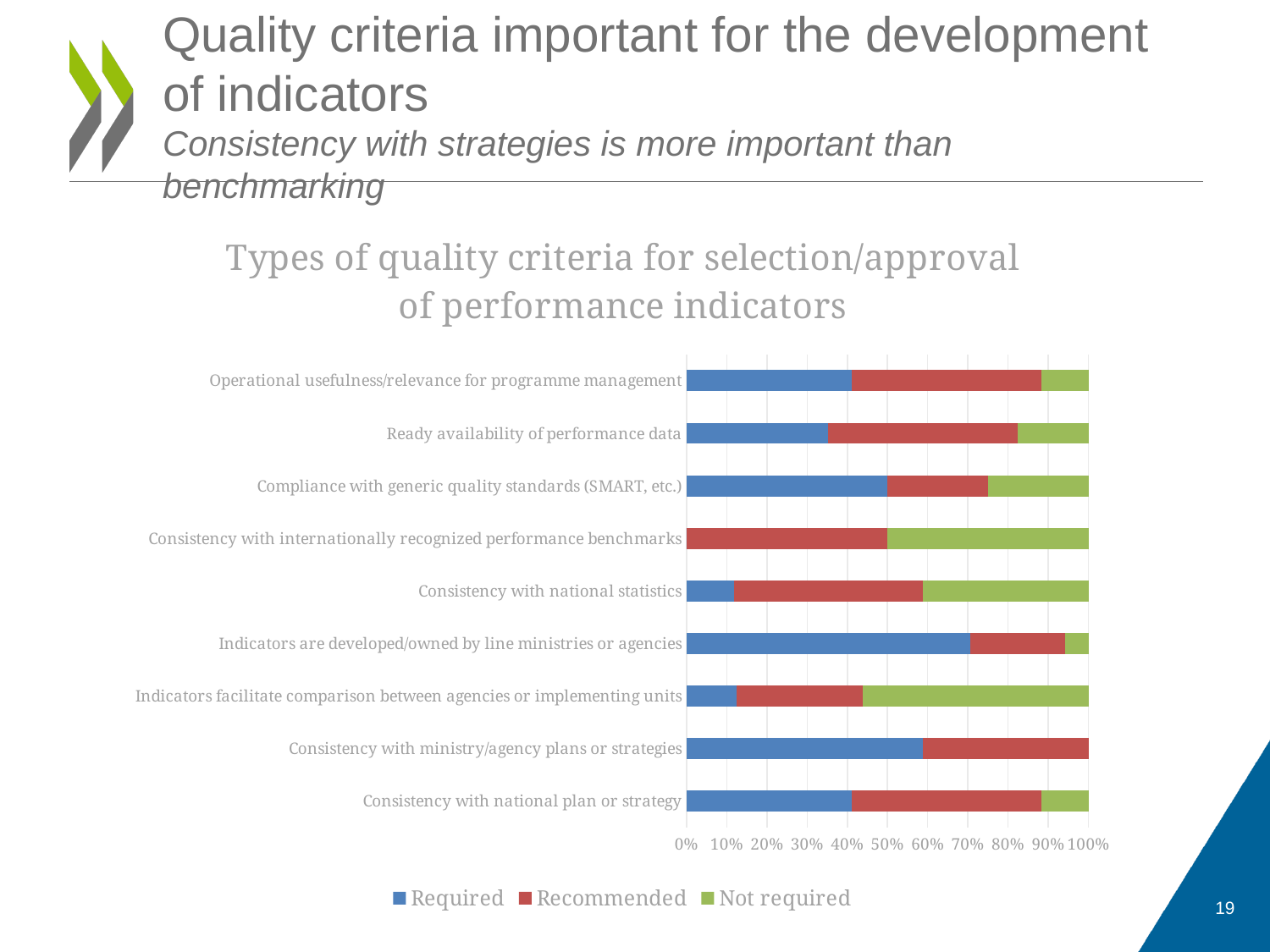
Which category has the largest 'Required' share? Indicators are developed/owned by line ministries or agencies What is the title of the chart? Types of quality criteria for selection/approval of performance indicators Which series is shown in blue in the chart? Required How many quality criteria (categories) are plotted in the chart? 9 Which category has no 'Required' segment at all (the smallest 'Required' share)? Consistency with internationally recognized performance benchmarks Is the 'Required' share for 'Ready availability of performance data' greater or less than 40%? less How many series does the chart legend list? 3 What kind of chart is shown on the slide? Stacked bar chart Which has the larger 'Required' share: 'Consistency with ministry/agency plans or strategies' or 'Consistency with national plan or strategy'? Consistency with ministry/agency plans or strategies Is the 'Required' share for 'Consistency with national statistics' greater or less than 20%? less Is the 'Required' share for 'Indicators are developed/owned by line ministries or agencies' greater or less than 60%? greater Which category has no 'Not required' segment (the smallest 'Not required' share)? Consistency with ministry/agency plans or strategies